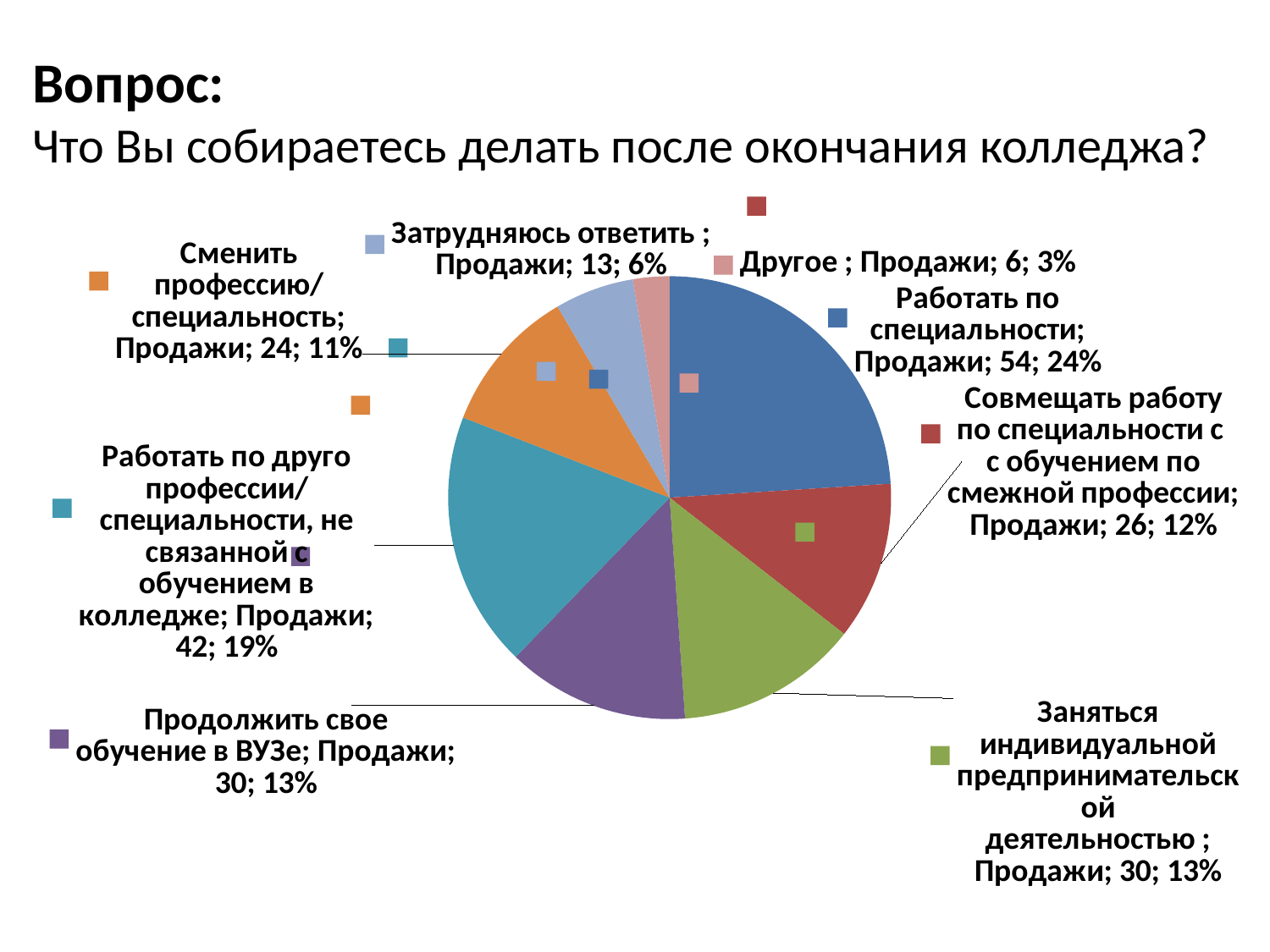
What is the difference between the values for "Работать по специальности" (54) and "Сменить профессию/специальность" (24)? 30 What percentage share is shown for "Затрудняюсь ответить"? 6% Which is larger: the value for "Совмещать работу по специальности с обучением по смежной профессии" or the value for "Сменить профессию/специальность"? Совмещать работу по специальности с обучением по смежной профессии What value is shown for "Продолжить свое обучение в ВУЗе"? 30 How many slices does the pie chart have? 8 Which category has the smallest slice of the pie? Другое What is the question stated in the slide title? Что Вы собираетесь делать после окончания колледжа? What percentage share is shown for "Работать по специальности"? 24% Which category has the largest slice of the pie? Работать по специальности What value is shown for "Работать по специальности"? 54 What percentage share is shown for "Работать по другой профессии/специальности, не связанной с обучением в колледже"? 19% What kind of chart is shown on the slide? pie chart